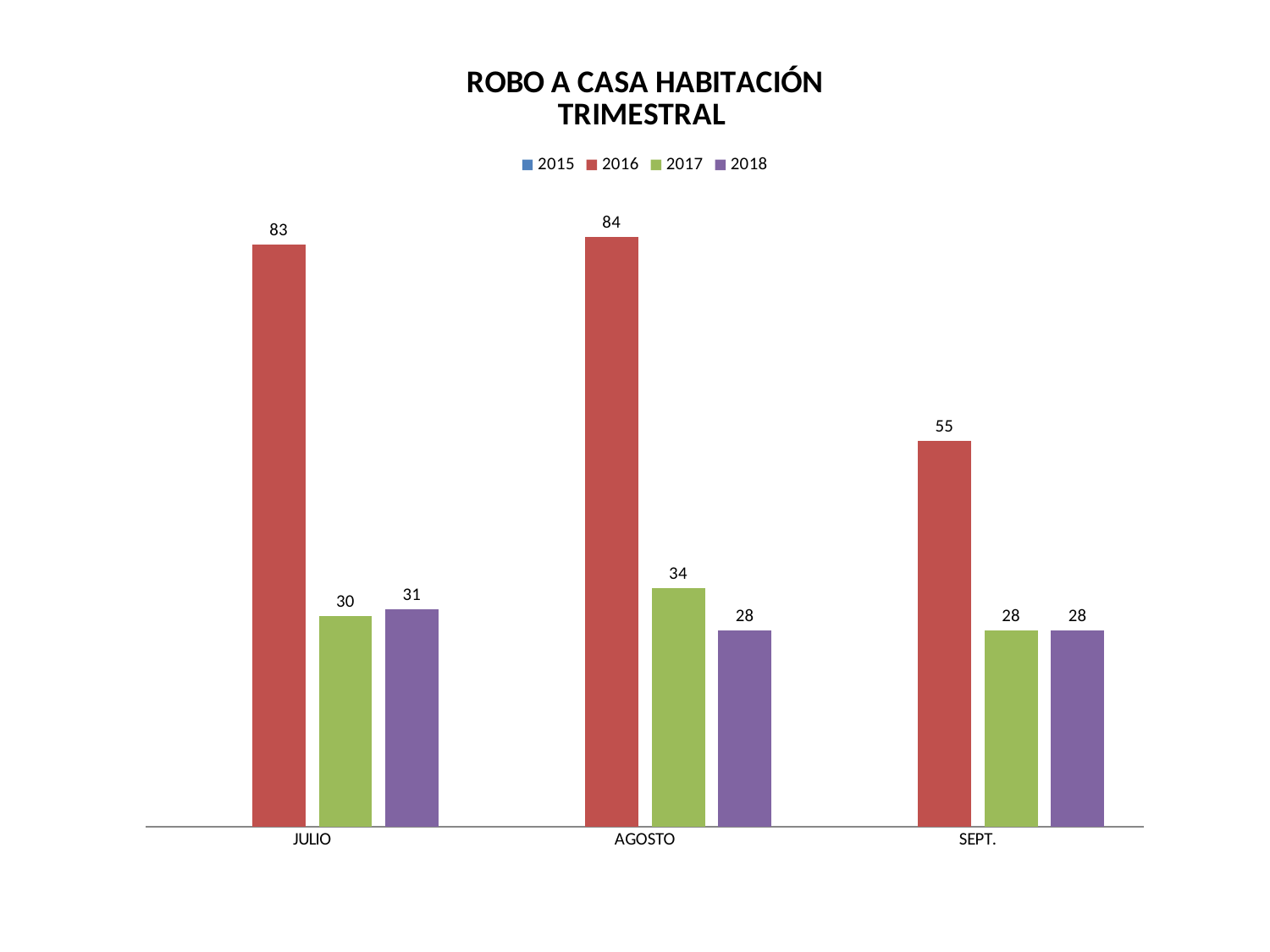
Which month has the lowest value for 2016? SEPT. What kind of chart is shown? bar chart What is the difference between the 2016 values for AGOSTO and SEPT.? 29 What is the value for 2016 in JULIO? 83 How many series does the legend list? 4 What is the value for 2017 in AGOSTO? 34 Which month has the highest value for 2016? AGOSTO What is the difference between the 2016 and 2017 values in JULIO? 53 What is the title of the chart? ROBO A CASA HABITACIÓN TRIMESTRAL How many months are shown on the x axis? 3 What is the value for 2018 in SEPT.? 28 Which is larger, the 2017 value in AGOSTO or the 2018 value in AGOSTO? 2017 value in AGOSTO